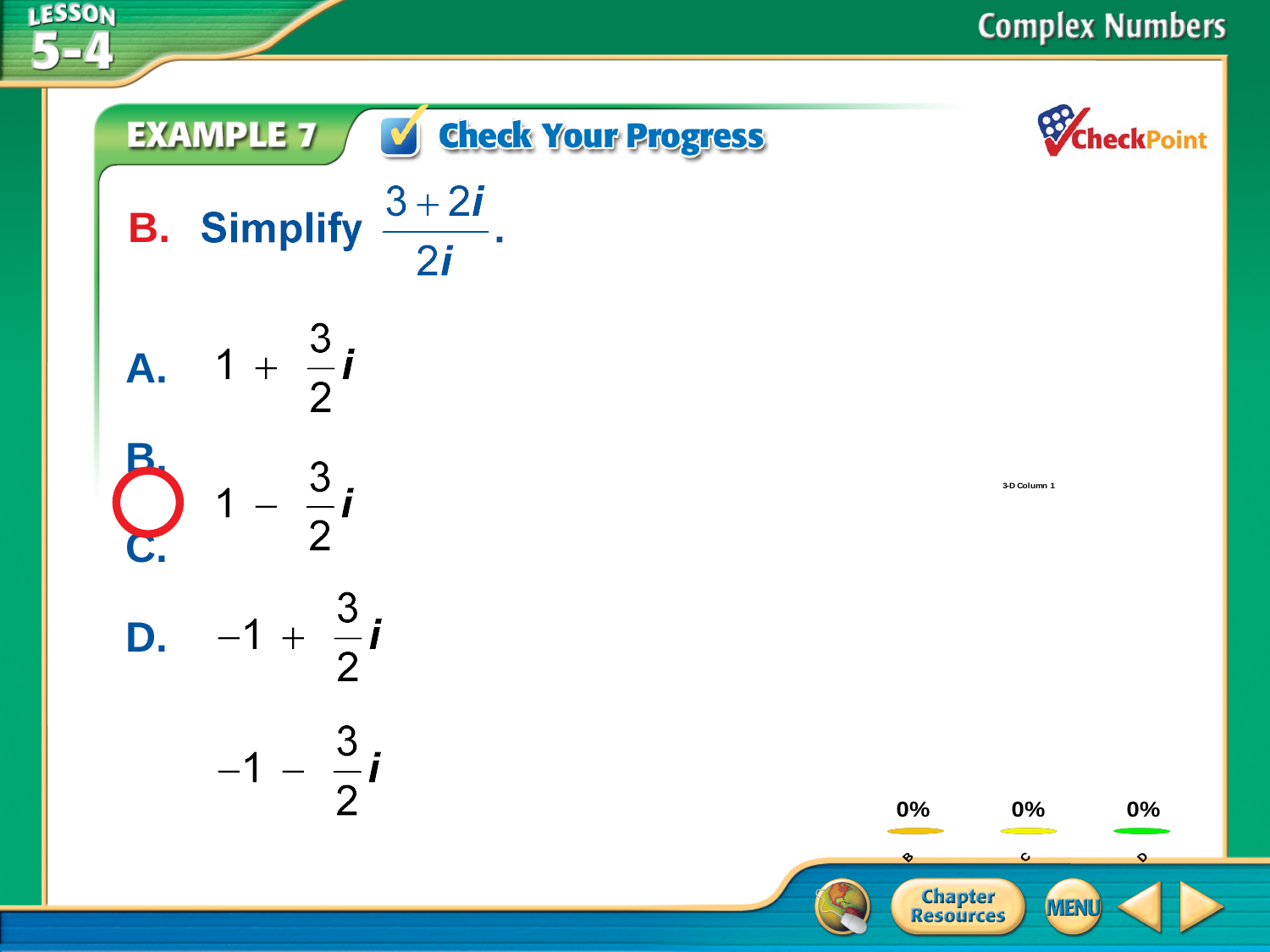
What kind of chart is shown at the bottom right of the slide? bar chart In the chart at the bottom right, what value is shown for category B? 0% What is the difference between the values for B and D in the chart at the bottom right? 0% In the chart at the bottom right, what value is shown for category C? 0% In the chart at the bottom right, what value is shown for category D? 0% How many bars with data labels are visible in the chart at the bottom right? 3